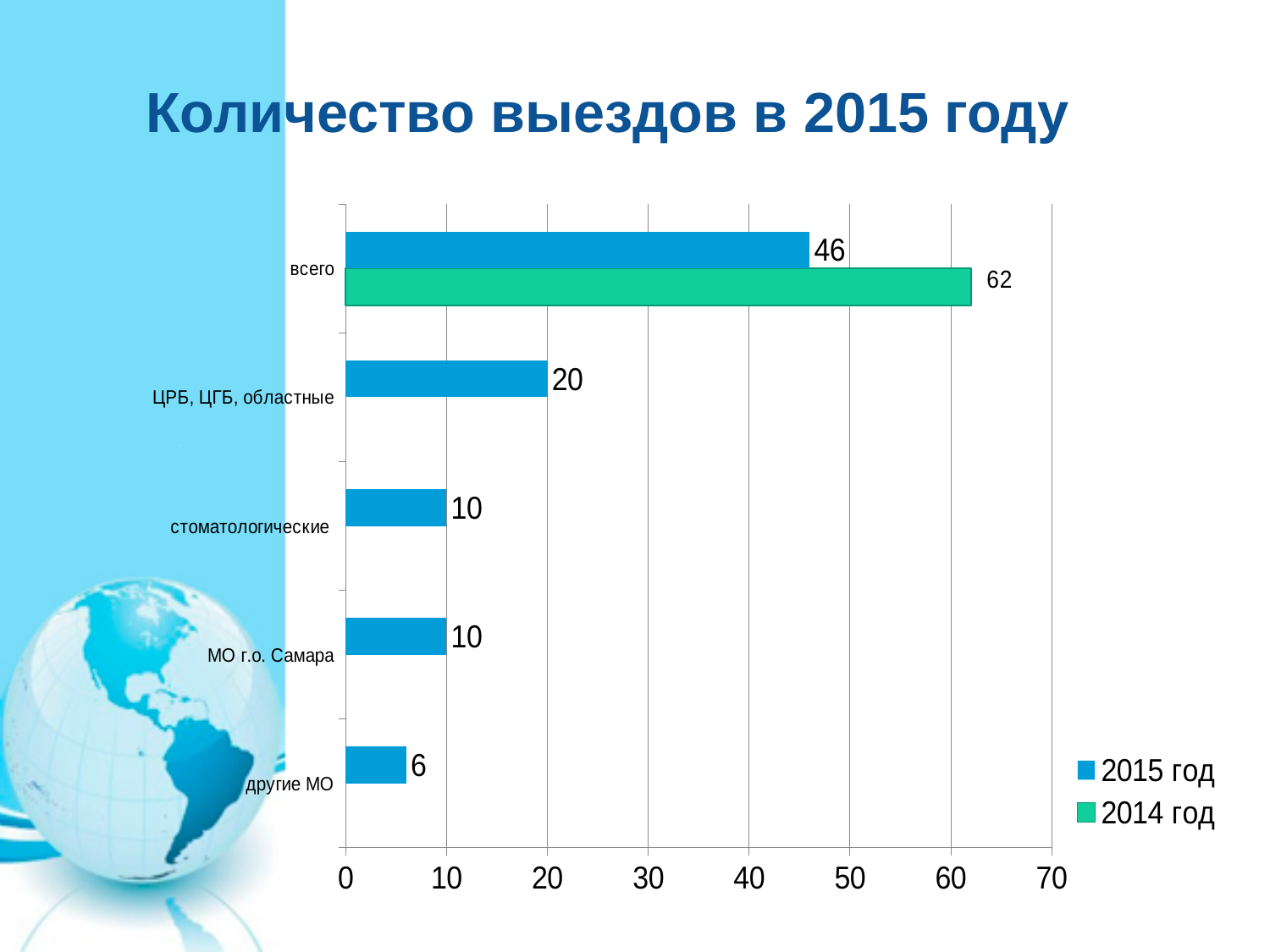
What kind of chart is shown on the slide? bar chart How many categories are shown on the vertical axis? 5 What is the value for "всего" in the "2015 год" series? 46 What is the value for "стоматологические" in 2015? 10 Which is larger for "всего": the 2015 value or the 2014 value? 2014 год How many series does the legend list? 2 What is the difference between the 2014 and 2015 values for "всего"? 16 What is the value for "ЦРБ, ЦГБ, областные" in 2015? 20 Which category has the lowest value in the 2015 series? другие МО What is the value for "другие МО" in 2015? 6 Excluding "всего", which category has the highest value in the 2015 series? ЦРБ, ЦГБ, областные What is the value for "всего" in the "2014 год" series? 62